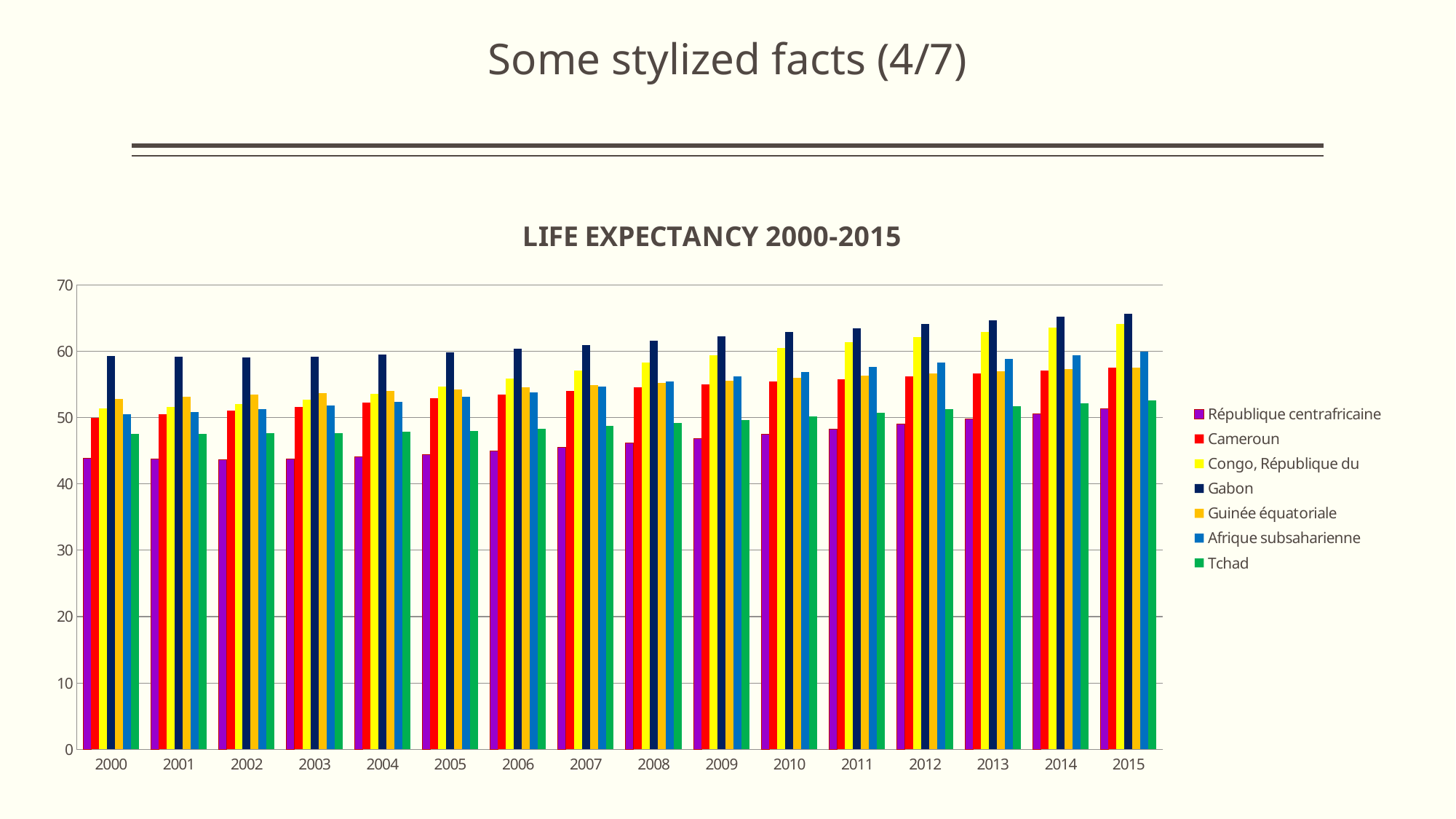
Is the value for République centrafricaine in 2000 greater or less than 50? less How many years are shown along the x axis? 16 Which colour represents Gabon in the legend? dark navy blue Does the life expectancy for Gabon rise or fall from 2000 to 2015? rise What kind of chart is shown on the slide? bar chart Is the value for Gabon in 2015 greater or less than 60? greater Which country has the highest life expectancy in 2015? Gabon What is the title of the chart? LIFE EXPECTANCY 2000-2015 In 2010, which is larger: the value for Cameroun or the value for Tchad? Cameroun Is the value for Afrique subsaharienne in 2000 greater or less than 60? less Which series has the lowest life expectancy in 2000? République centrafricaine How many series does the legend list? 7